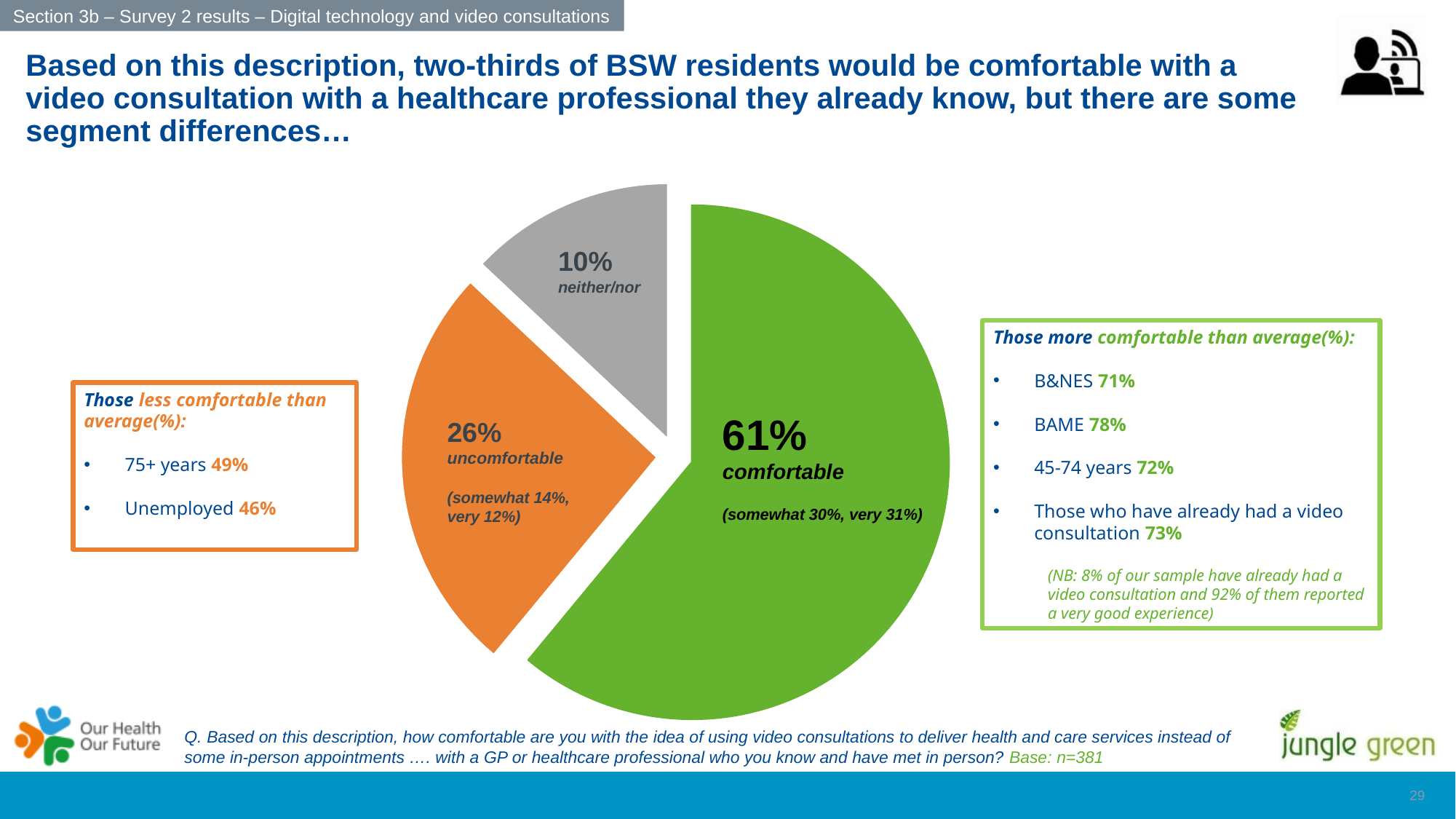
Which is larger, the uncomfortable slice or the neither/nor slice? uncomfortable What is the difference in percentage points between the comfortable and uncomfortable slices? 35 How many slices does the pie chart have? 3 Which slice of the pie chart is the largest? comfortable What percentage of respondents answered neither/nor? 10% What colour is the comfortable slice of the pie chart? green What percentage of respondents are uncomfortable? 26% What percentage of respondents are comfortable with a video consultation? 61% Which slice of the pie chart is the smallest? neither/nor What percentage of respondents are somewhat uncomfortable? 14% What percentage of respondents are very comfortable? 31% What kind of chart is shown on the slide? pie chart